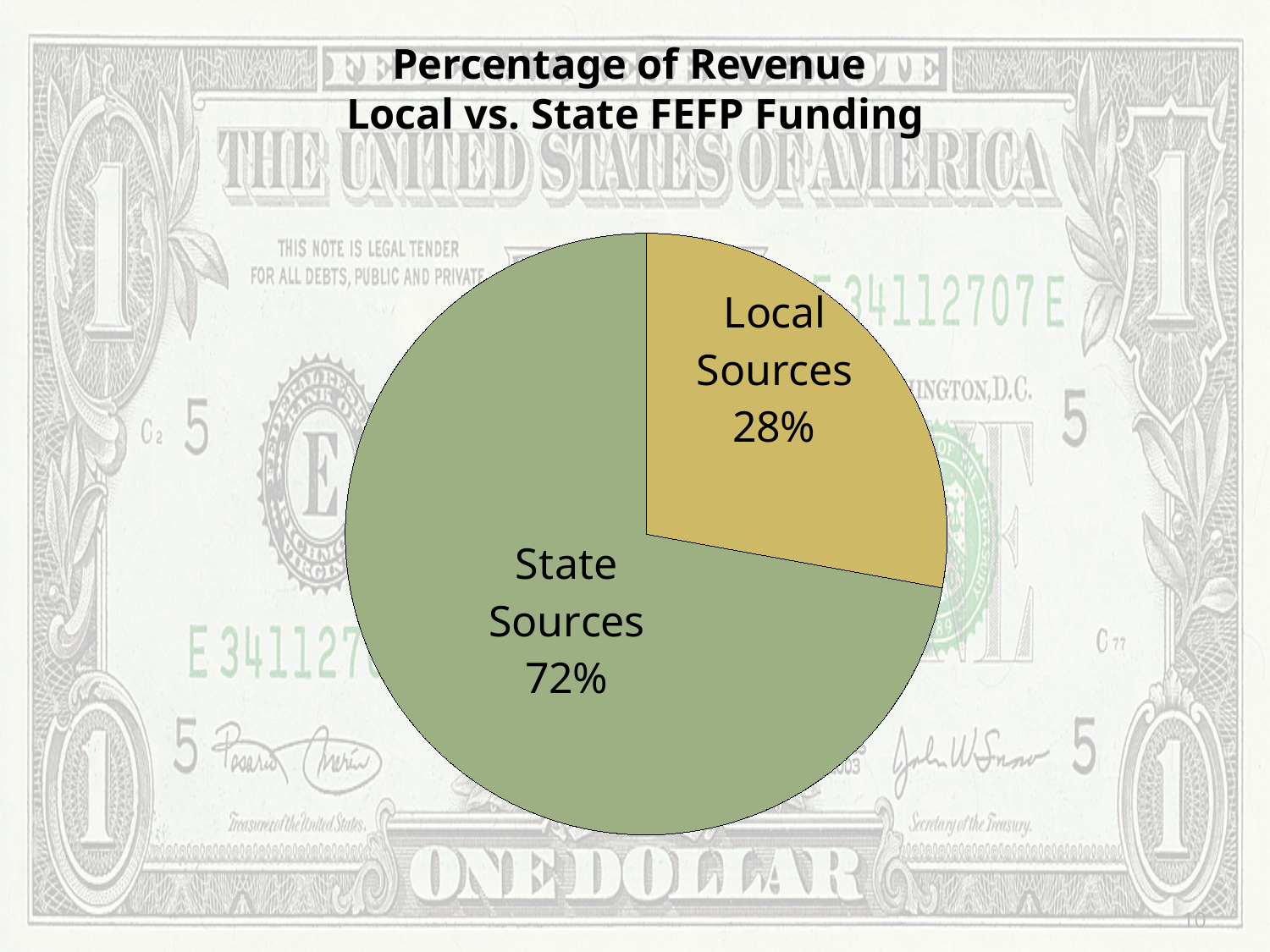
Which source accounts for the largest share of revenue? State Sources What is the title of the chart? Percentage of Revenue Local vs. State FEFP Funding Which is larger, the share for Local Sources or the share for State Sources? State Sources What colour is the State Sources slice? green How many slices does the pie chart have? 2 Which source accounts for the smallest share of revenue? Local Sources What share of the pie does the Local Sources slice represent? 28% What kind of chart is shown on the slide? pie chart What percentage of revenue comes from Local Sources? 28% What percentage of revenue comes from State Sources? 72% What is the difference in percentage points between State Sources and Local Sources? 44